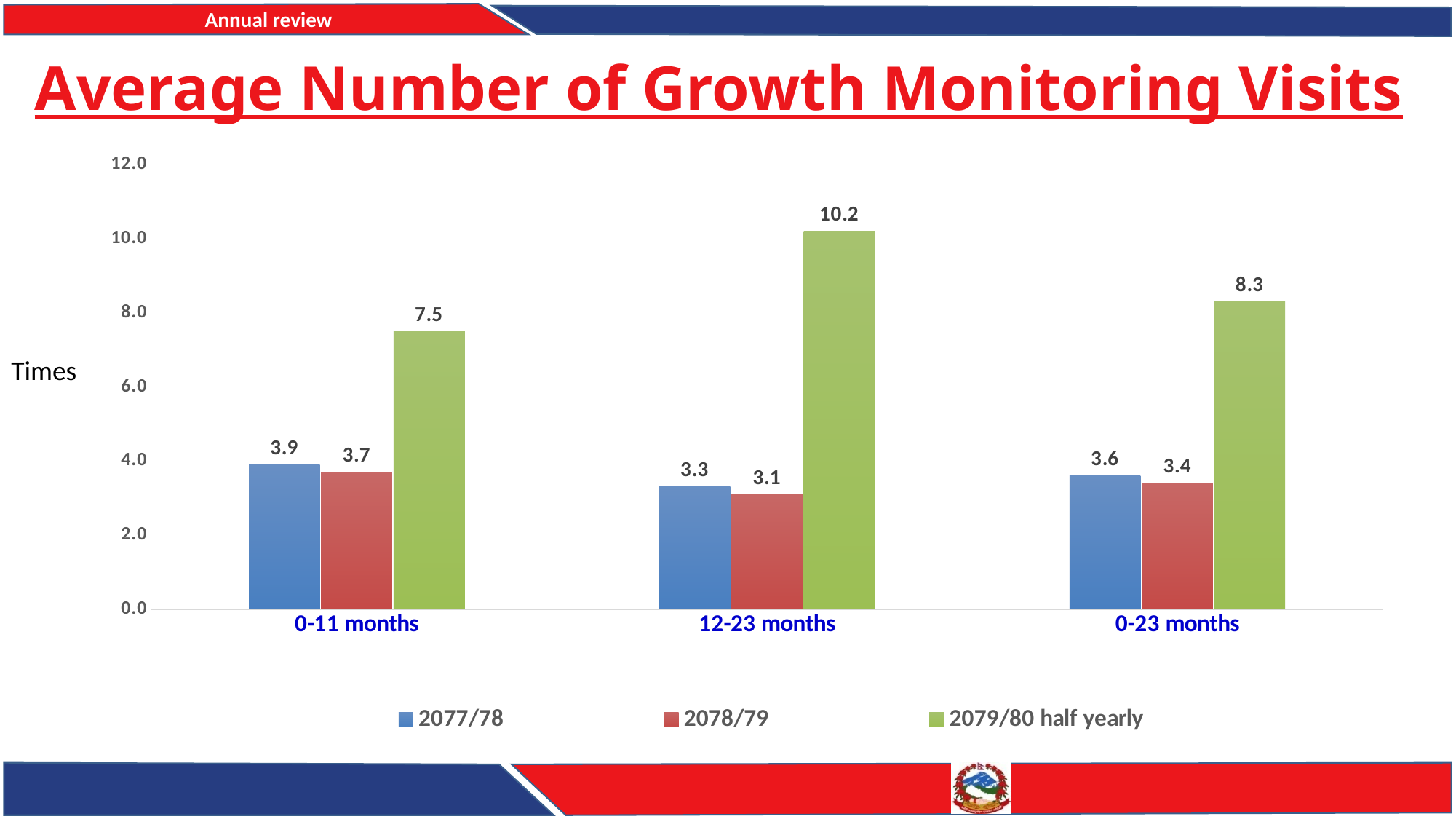
Which category has the lowest value for the 2078/79 series? 12-23 months Is the value for 2079/80 half yearly in the 0-23 months category greater or less than 8.0? greater What is the value for 2077/78 in the 0-11 months category? 3.9 Which is larger in the 0-23 months category: the 2077/78 value or the 2078/79 value? 2077/78 What is the value for 2078/79 in the 0-23 months category? 3.4 How many series does the legend list? 3 What is the difference between the 2079/80 half yearly and 2077/78 values in the 0-11 months category? 3.6 How many categories are shown on the x axis? 3 Which category has the highest value for the 2079/80 half yearly series? 12-23 months What is the label on the vertical axis? Times What is the value for 2079/80 half yearly in the 12-23 months category? 10.2 What kind of chart is shown on the slide? Bar chart